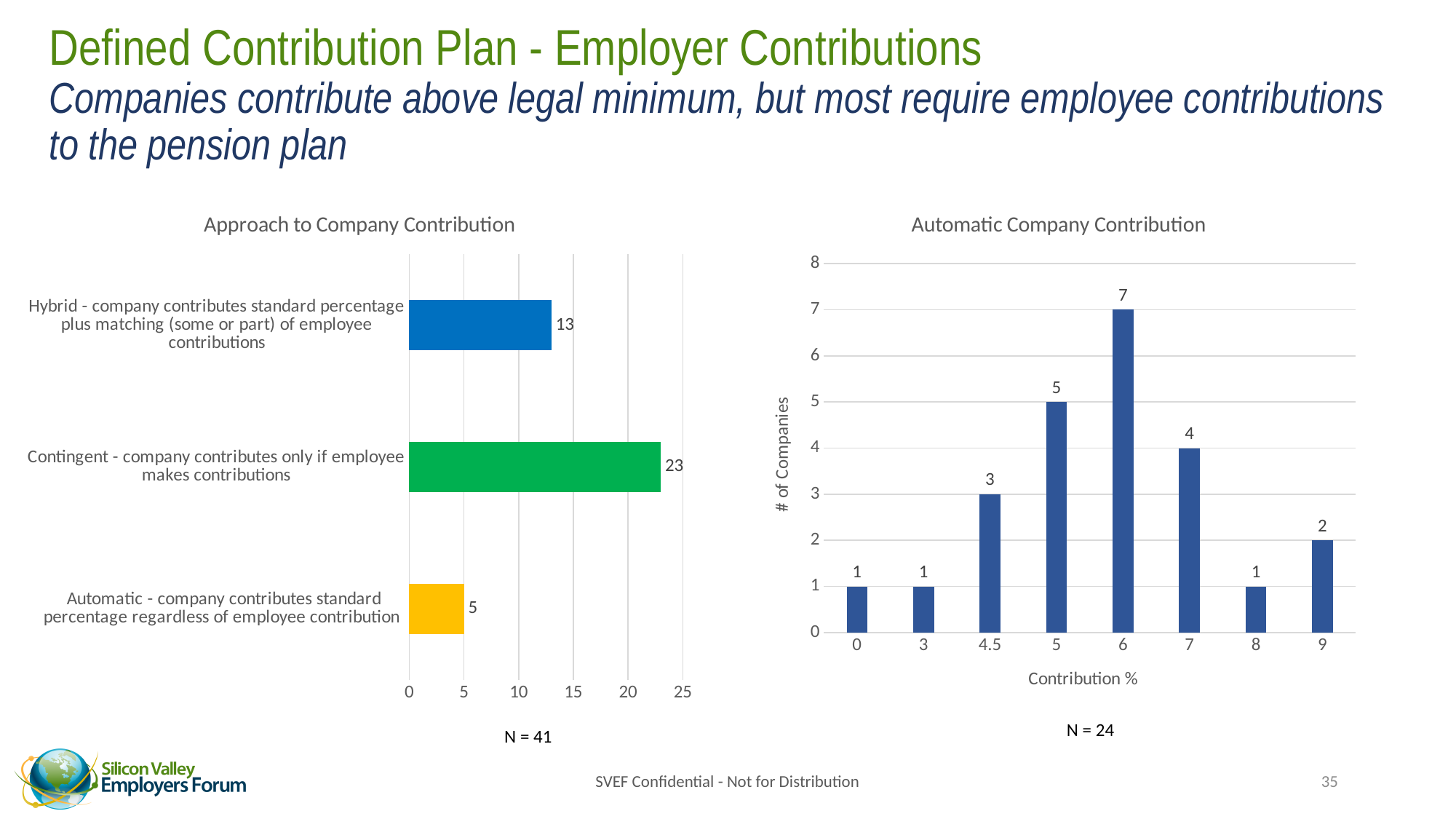
In the 'Automatic Company Contribution' chart, which has more companies: 5% or 7%? 5% What is the label of the y axis in the 'Automatic Company Contribution' chart? # of Companies In the 'Approach to Company Contribution' chart, how many categories are shown? 3 In the 'Automatic Company Contribution' chart, which contribution % has the highest number of companies? 6 In the 'Automatic Company Contribution' chart, what is the difference between the number of companies at 6% and at 9%? 5 In the 'Approach to Company Contribution' chart, what is the difference between the Contingent and Hybrid values? 10 In the 'Approach to Company Contribution' chart, which approach has the lowest value? Automatic In the 'Automatic Company Contribution' chart, how many companies have a contribution of 6%? 7 In the 'Approach to Company Contribution' chart, what is the value for the Contingent approach? 23 What kind of chart is the 'Approach to Company Contribution' chart? Bar chart In the 'Automatic Company Contribution' chart, how many contribution % categories are shown? 8 In the 'Approach to Company Contribution' chart, what is the value for the Hybrid approach? 13